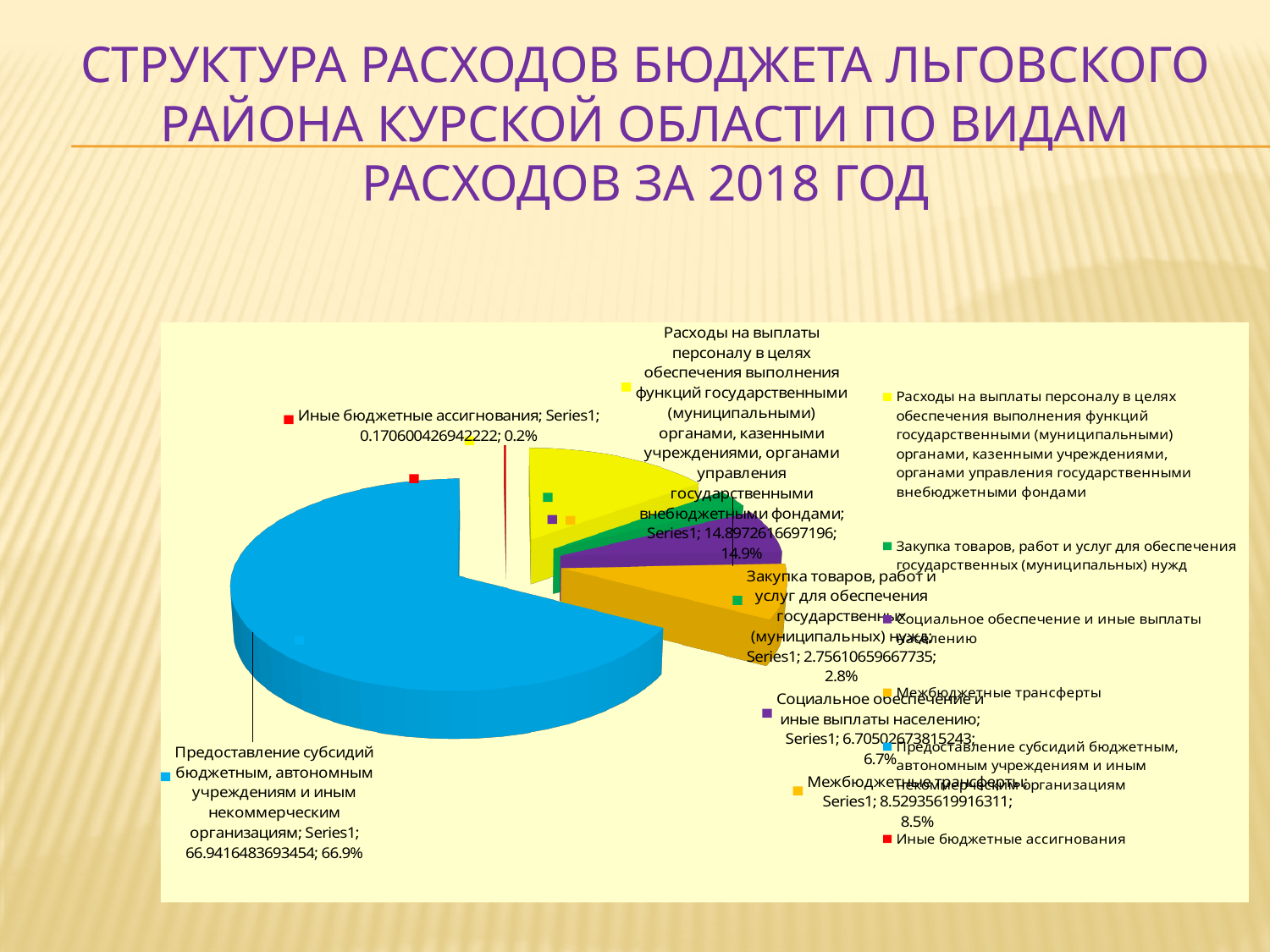
What colour is the slice for "Предоставление субсидий бюджетным, автономным учреждениям и иным некоммерческим организациям"? blue What percentage share is shown for "Межбюджетные трансферты"? 8.5% What kind of chart is shown on the slide? pie chart What percentage share is shown for "Закупка товаров, работ и услуг для обеспечения государственных (муниципальных) нужд"? 2.8% What percentage share is shown for "Иные бюджетные ассигнования"? 0.2% What percentage share is shown for "Предоставление субсидий бюджетным, автономным учреждениям и иным некоммерческим организациям"? 66.9% Which category has the smallest share of the pie? Иные бюджетные ассигнования What percentage share is shown for "Расходы на выплаты персоналу в целях обеспечения выполнения функций государственными (муниципальными) органами, казенными учреждениями, органами управления государственными внебюджетными фондами"? 14.9% Which category has the largest share of the pie? Предоставление субсидий бюджетным, автономным учреждениям и иным некоммерческим организациям How many categories (slices) does the pie chart have? 6 What percentage share is shown for "Социальное обеспечение и иные выплаты населению"? 6.7% Which has a larger share: "Межбюджетные трансферты" or "Социальное обеспечение и иные выплаты населению"? Межбюджетные трансферты